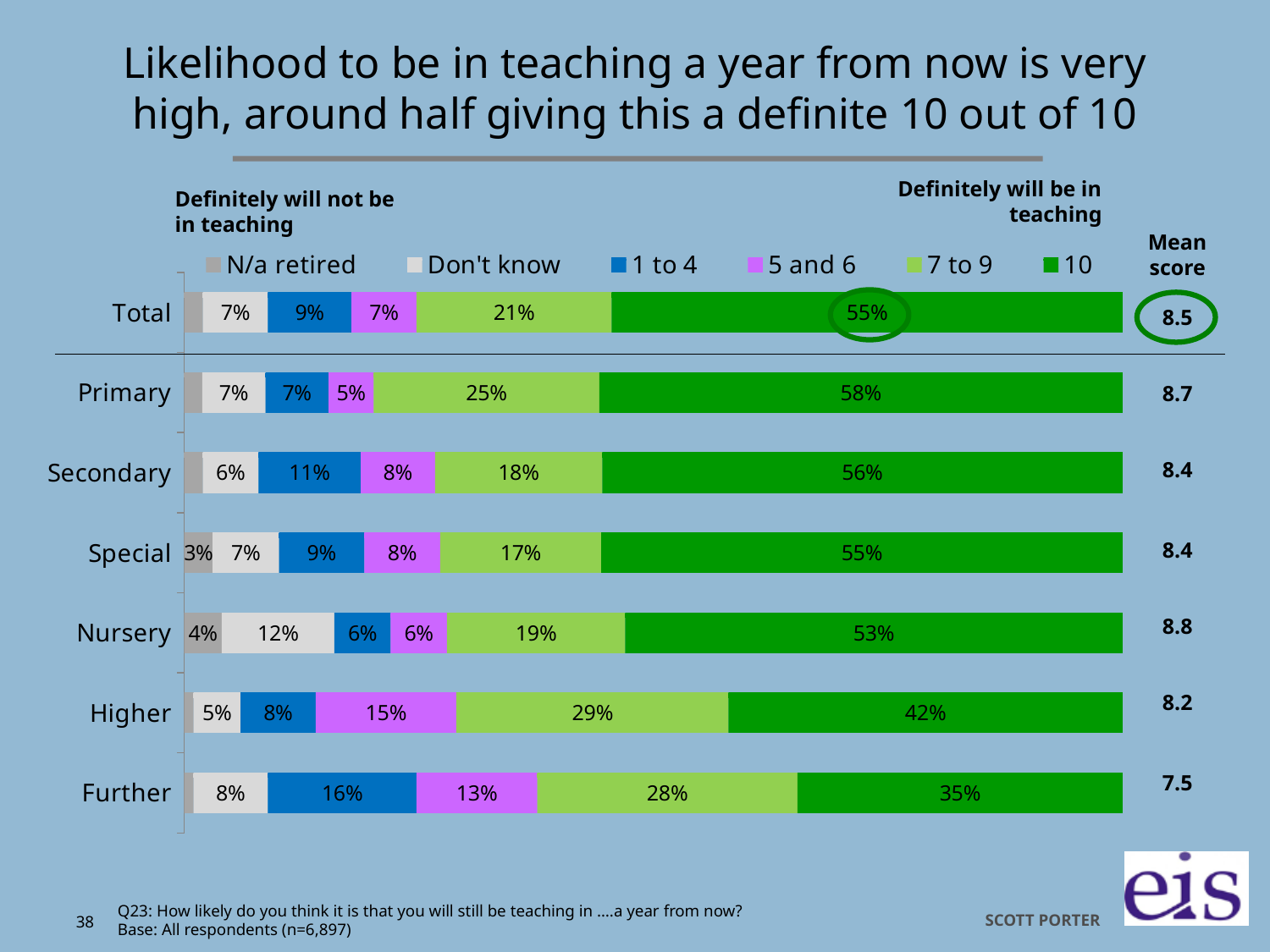
What percentage of Primary respondents gave a score of 10? 58% What is the mean score for Further? 7.5 What is the 'Don't know' value for Nursery? 12% Which category has the highest percentage giving a score of 10? Primary How many series does the legend list? 6 What is the '7 to 9' value for Higher? 29% Which category has the lowest percentage giving a score of 10? Further How many categories (rows) are shown in the chart? 7 Which category has the highest mean score? Nursery What is the difference between the '10' value for Primary and the '10' value for Further? 23 percentage points What kind of chart is shown on the slide? Stacked bar chart Which has a larger '1 to 4' value, Secondary or Special? Secondary